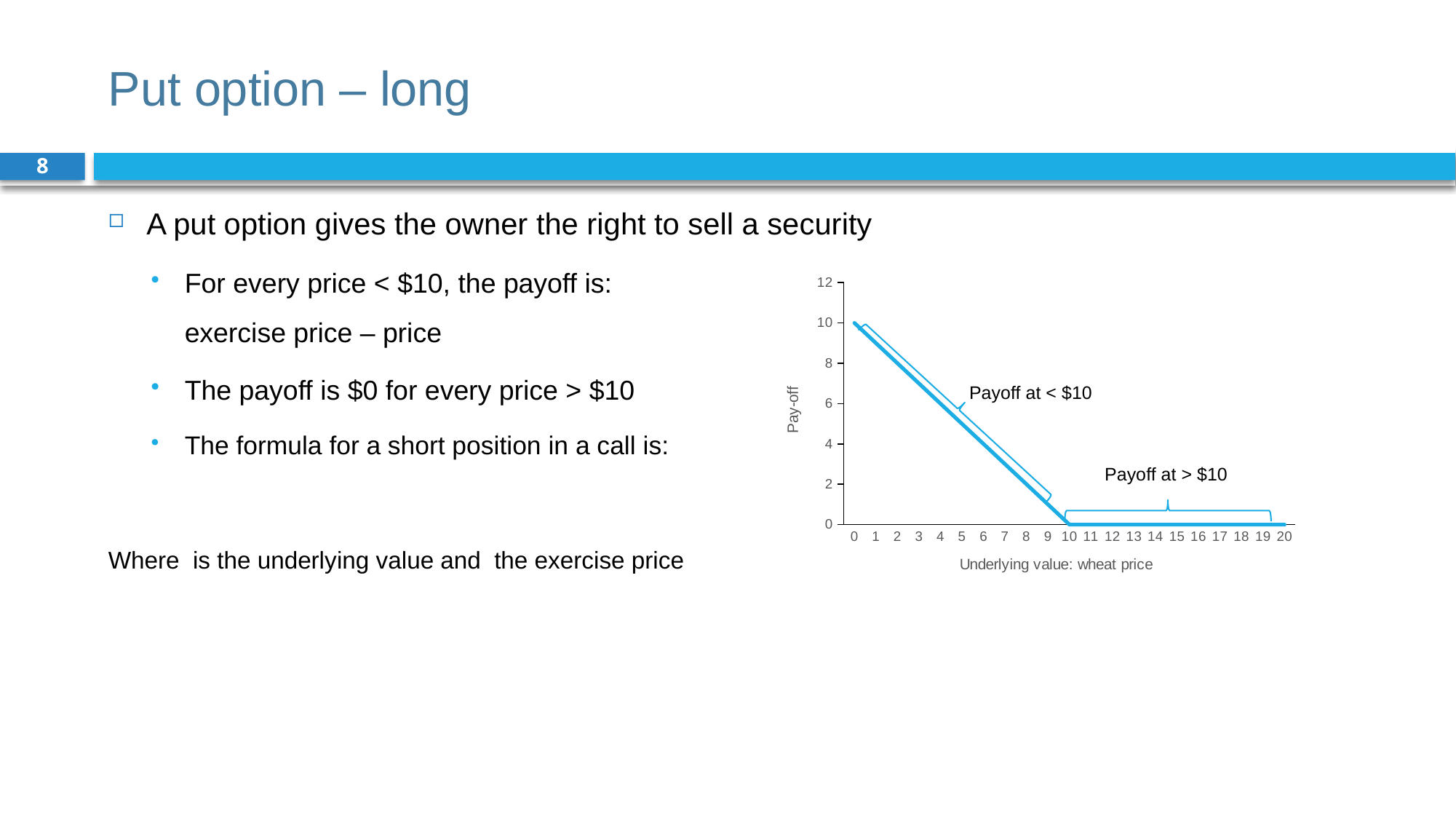
Which is larger, the pay-off at a wheat price of 3 or at a wheat price of 8? wheat price of 3 Does the pay-off rise or fall as the wheat price increases from 0 to 10? fall What is the pay-off when the wheat price is 0? 10 Is the pay-off at a wheat price of 5 greater or less than 8? less At which wheat price is the pay-off highest? 0 What is the label of the x axis? Underlying value: wheat price What is the pay-off when the wheat price is 15? 0 What is the pay-off when the wheat price is 10? 0 Is the pay-off at a wheat price of 2 greater or less than 6? greater What is the label of the y axis? Pay-off What is the pay-off when the wheat price is 20? 0 What kind of chart is shown on the slide? line chart